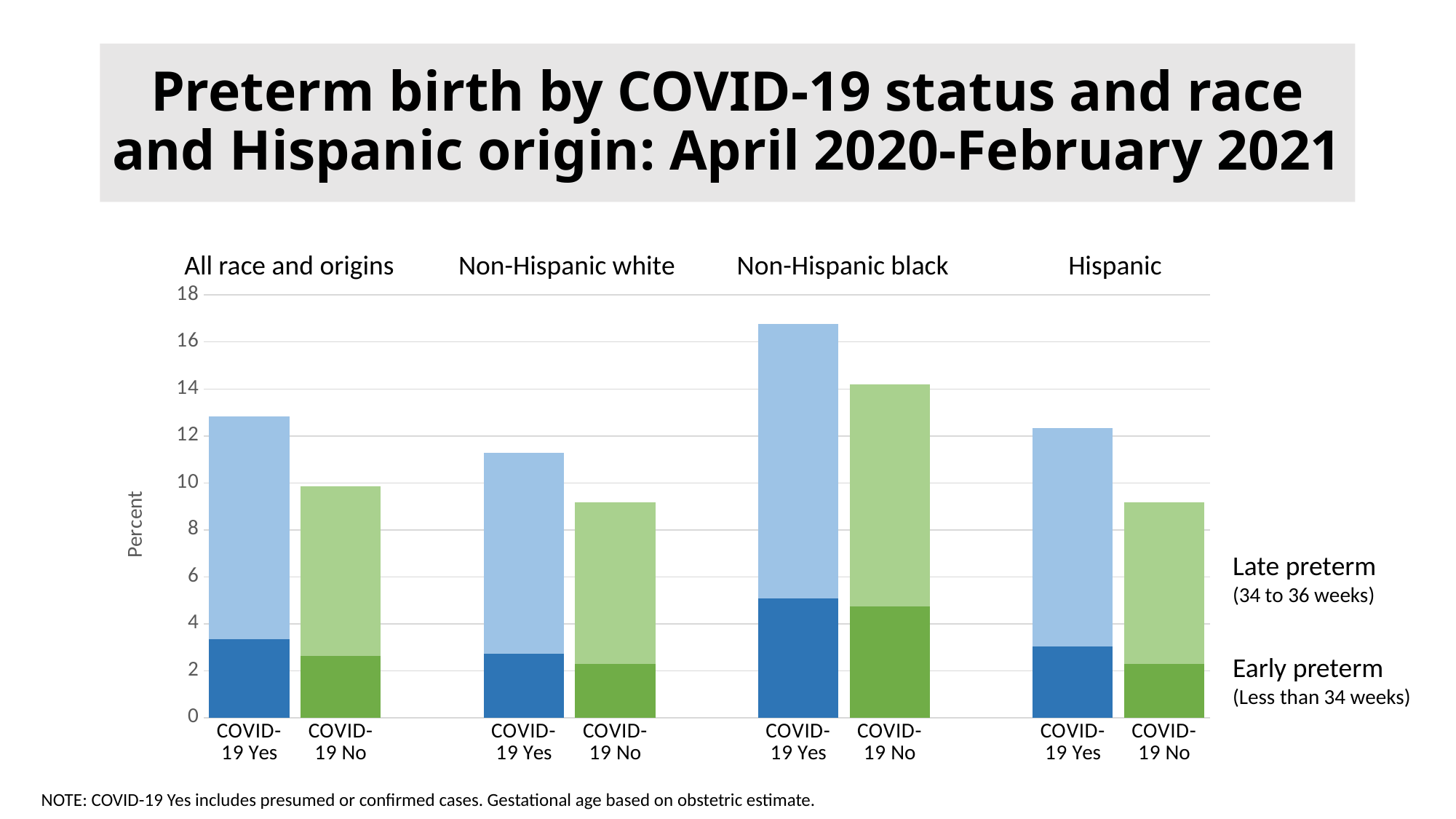
Which bar has the highest total preterm birth percentage? Non-Hispanic black, COVID-19 Yes Is the total preterm percentage for Hispanic COVID-19 Yes greater or less than 10? greater What kind of chart is shown on the slide? Stacked bar chart Is the total preterm percentage for Non-Hispanic white COVID-19 Yes greater or less than 12? less What is the label on the vertical axis of the chart? Percent Which has the larger early preterm percentage: Non-Hispanic black COVID-19 Yes or All race and origins COVID-19 Yes? Non-Hispanic black COVID-19 Yes Is the total preterm percentage for Non-Hispanic black COVID-19 Yes greater or less than 16? greater How many series does the legend list? 2 How many bars are plotted in the chart? 8 How many race and Hispanic origin groups are shown in the chart? 4 For the Hispanic group, which bar has the larger total preterm percentage, COVID-19 Yes or COVID-19 No? COVID-19 Yes